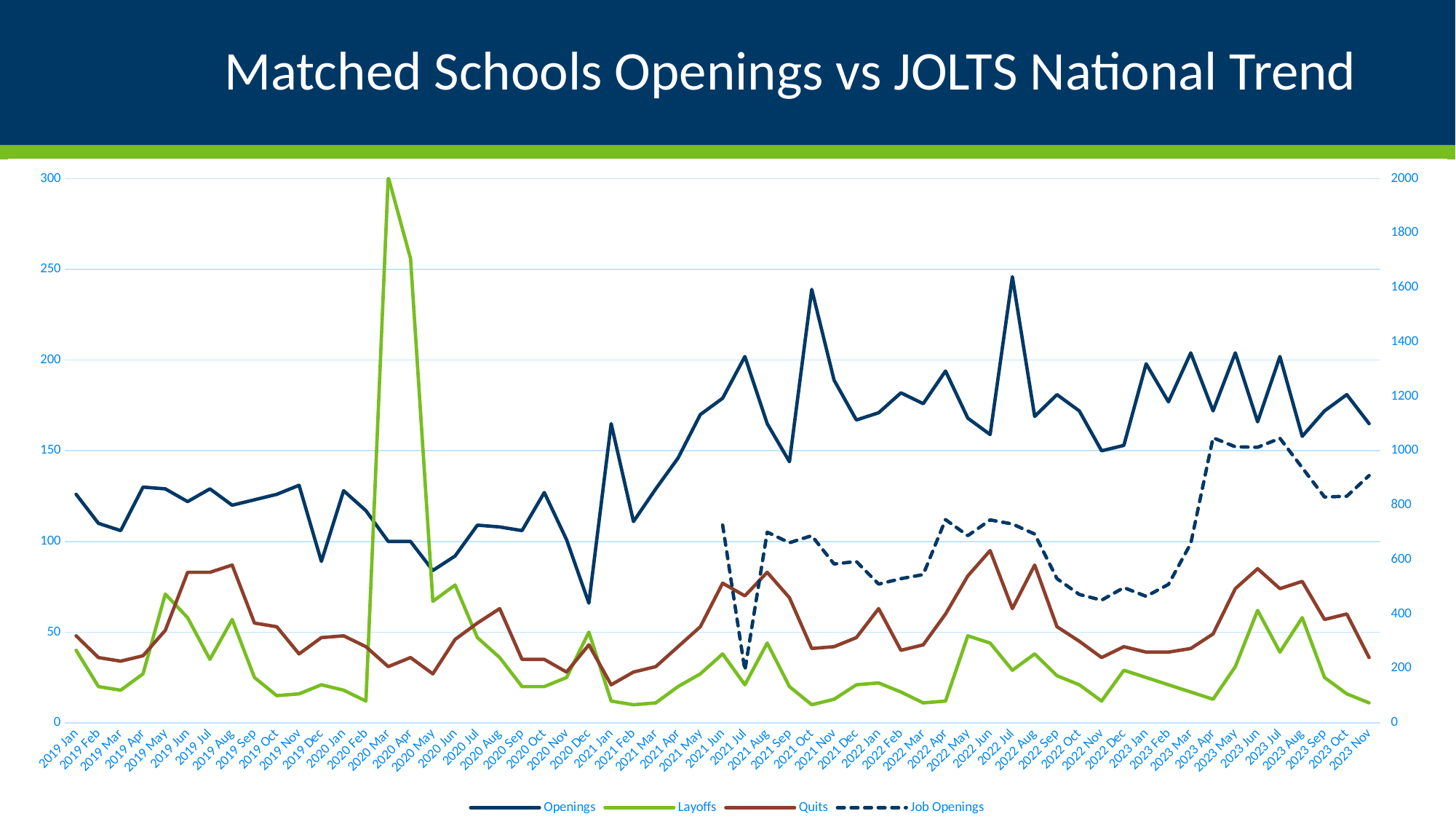
Which series is drawn with a dashed line? Job Openings What kind of chart is shown on the slide? Line chart Is the Openings value for 2020 Dec greater or less than 100 on the left axis? less Which is larger in 2021 Jan, Openings or Layoffs? Openings In which month does the Layoffs series reach its highest value? 2020 Mar Is the Openings value for 2021 Oct greater or less than 200 on the left axis? greater Which is larger in 2019 Jun, Quits or Layoffs? Quits Does the Layoffs series rise or fall from 2020 Mar to 2020 May? Fall Is the Layoffs value for 2020 Mar greater or less than 250 on the left axis? greater How many series does the legend list? 4 What is the title of the chart? Matched Schools Openings vs JOLTS National Trend How many monthly points are on the x axis, from 2019 Jan to 2023 Nov? 59